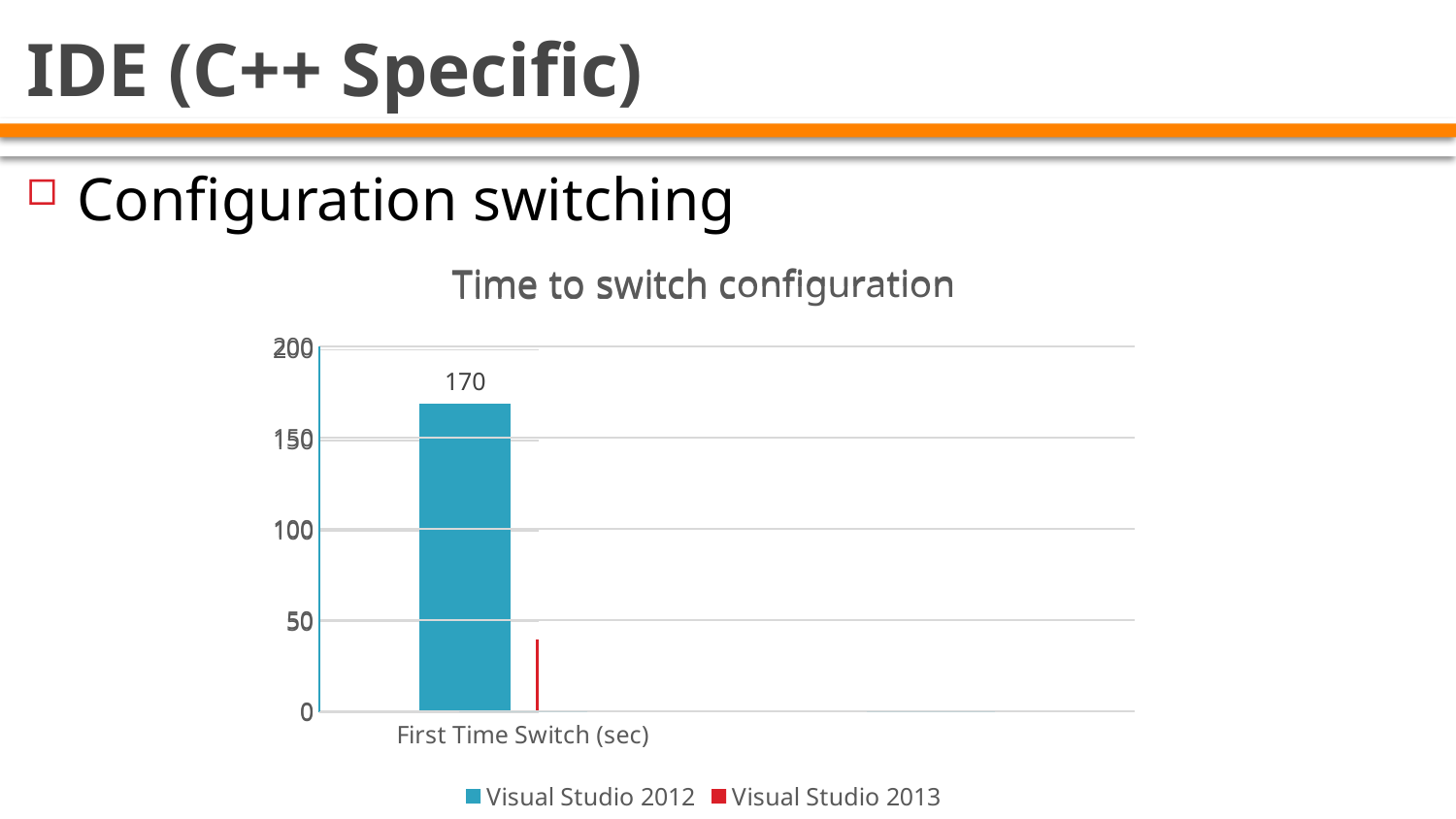
What kind of chart is shown? bar chart What is the value for Visual Studio 2012 for First Time Switch (sec)? 170 Is the value for Visual Studio 2013 greater or less than 50? less What is the title of the chart? Time to switch configuration What is the highest value shown on the y axis? 200 How many categories are shown on the x axis? 1 What colour represents Visual Studio 2013 in the chart? red Is the value for Visual Studio 2012 larger or smaller than the value for Visual Studio 2013? larger How many series does the legend list? 2 Which series has the lower value for First Time Switch (sec)? Visual Studio 2013 Is the value for Visual Studio 2012 greater or less than 150? greater Which series has the higher value for First Time Switch (sec)? Visual Studio 2012